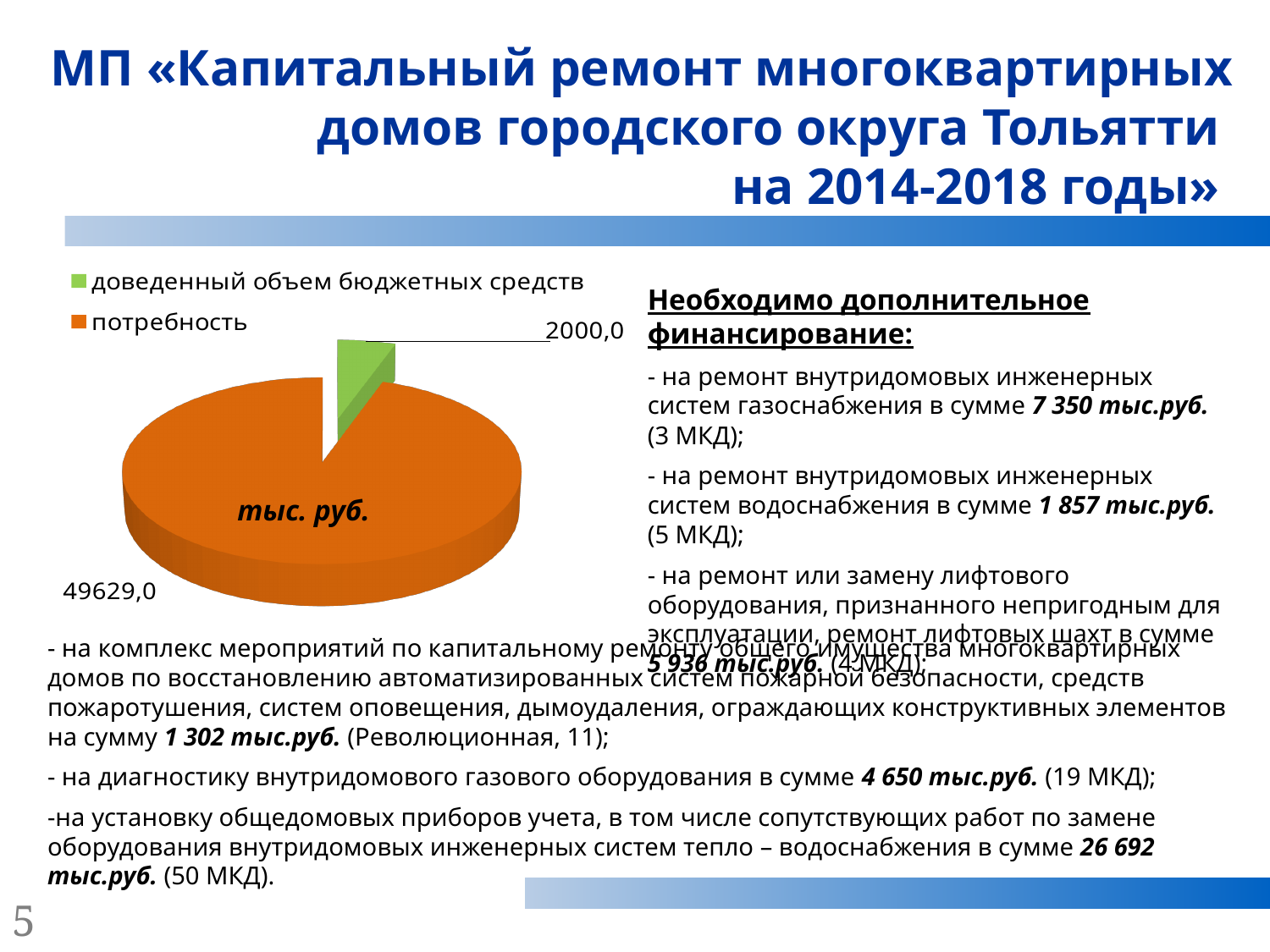
What kind of chart is shown on the slide? pie chart Which slice of the pie chart is the smallest? доведенный объем бюджетных средств What is the value for «доведенный объем бюджетных средств» in the pie chart? 2000,0 What is the difference between «потребность» and «доведенный объем бюджетных средств» in the pie chart? 47629,0 Which is larger in the pie chart: «потребность» or «доведенный объем бюджетных средств»? потребность How many entries does the legend of the pie chart list? 2 Which slice of the pie chart is the largest? потребность What is the total of the two slices in the pie chart? 51629,0 What unit label is printed inside the pie chart? тыс. руб. What colour is the «потребность» slice in the pie chart? orange What is the value for «потребность» in the pie chart? 49629,0 How many slices does the pie chart have? 2